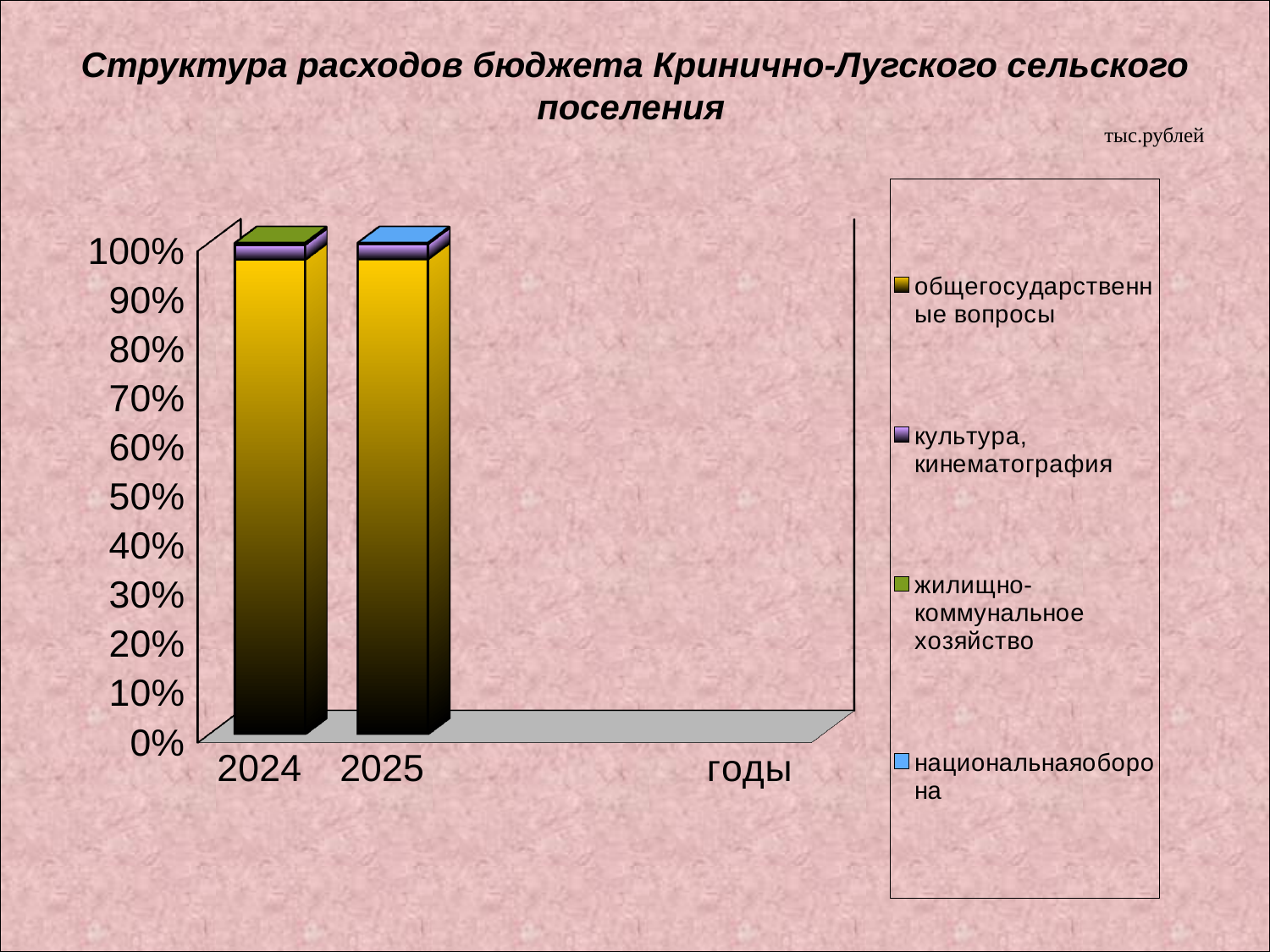
Which is larger in 2024: the share of общегосударственные вопросы or the share of жилищно-коммунальное хозяйство? общегосударственные вопросы What is the title of the chart? Структура расходов бюджета Кринично-Лугского сельского поселения Is the share of общегосударственные вопросы in 2025 greater or less than 90%? greater Is the share of национальная оборона in 2025 greater or less than 10%? less Which series makes up the largest share of the 2025 bar? общегосударственные вопросы What kind of chart is shown on the slide? bar chart Is the share of общегосударственные вопросы in 2024 greater or less than 90%? greater Which series makes up the largest share of the 2024 bar? общегосударственные вопросы How many years (categories) are plotted on the x axis? 2 How many series does the legend list? 4 What label is shown on the x axis? годы